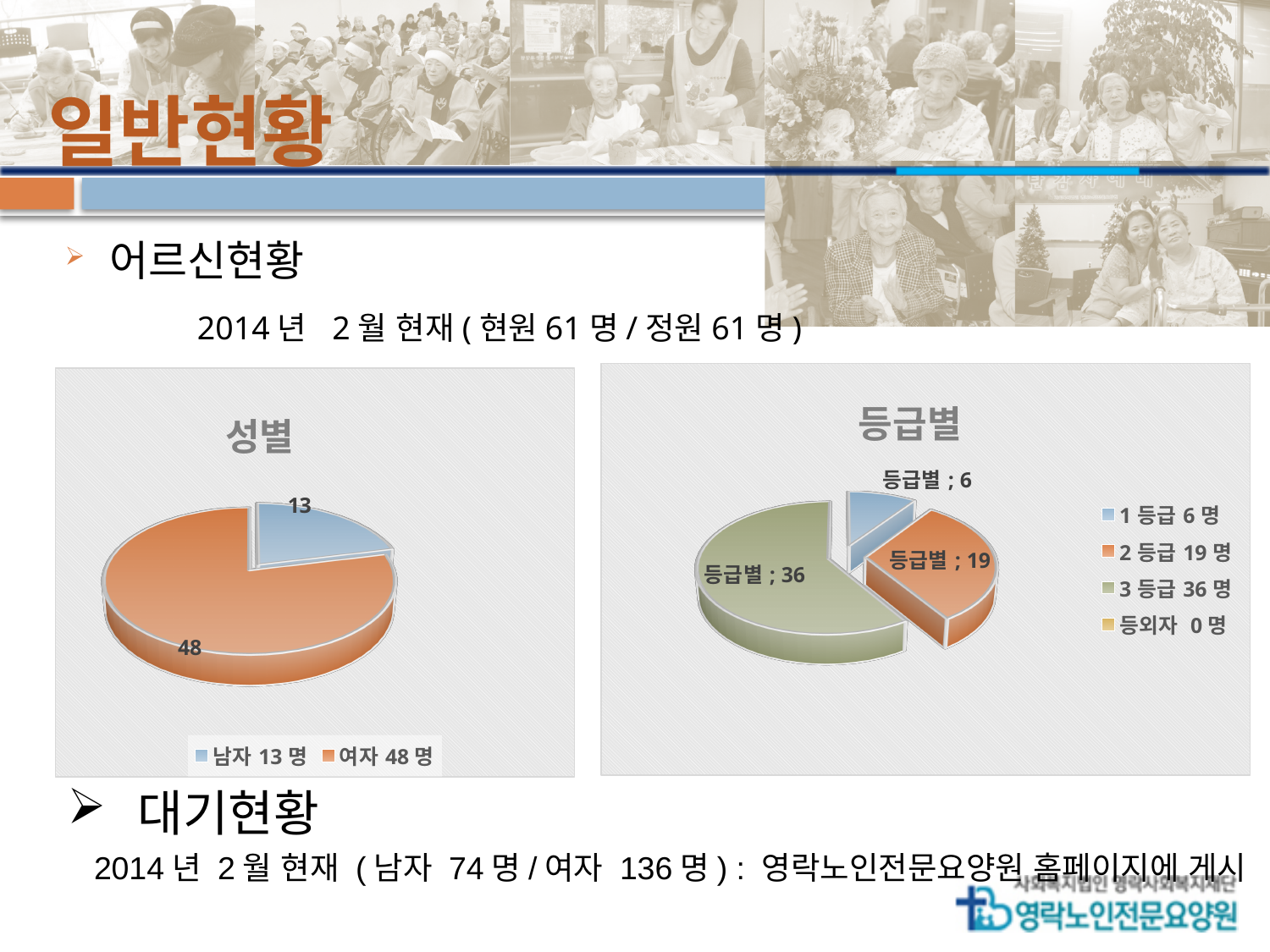
What kind of chart is the 성별 chart? pie chart In the 성별 chart, which category is larger, 남자 or 여자? 여자 How many entries does the legend of the 등급별 chart list? 4 In the 등급별 chart, how many people are in 2 등급? 19 How many slices does the 성별 pie chart have? 2 In the 등급별 chart, how many people are in 1 등급? 6 In the 성별 chart, what is the difference between the 여자 and 남자 values? 35 In the 등급별 chart, what is the total of all the values shown in the legend? 61 In the 등급별 chart, what is the difference between the 3 등급 and 1 등급 values? 30 In the 성별 chart, how many people are in the 남자 category? 13 In the 성별 chart, how many people are in the 여자 category? 48 In the 등급별 chart, which grade has the most people? 3 등급